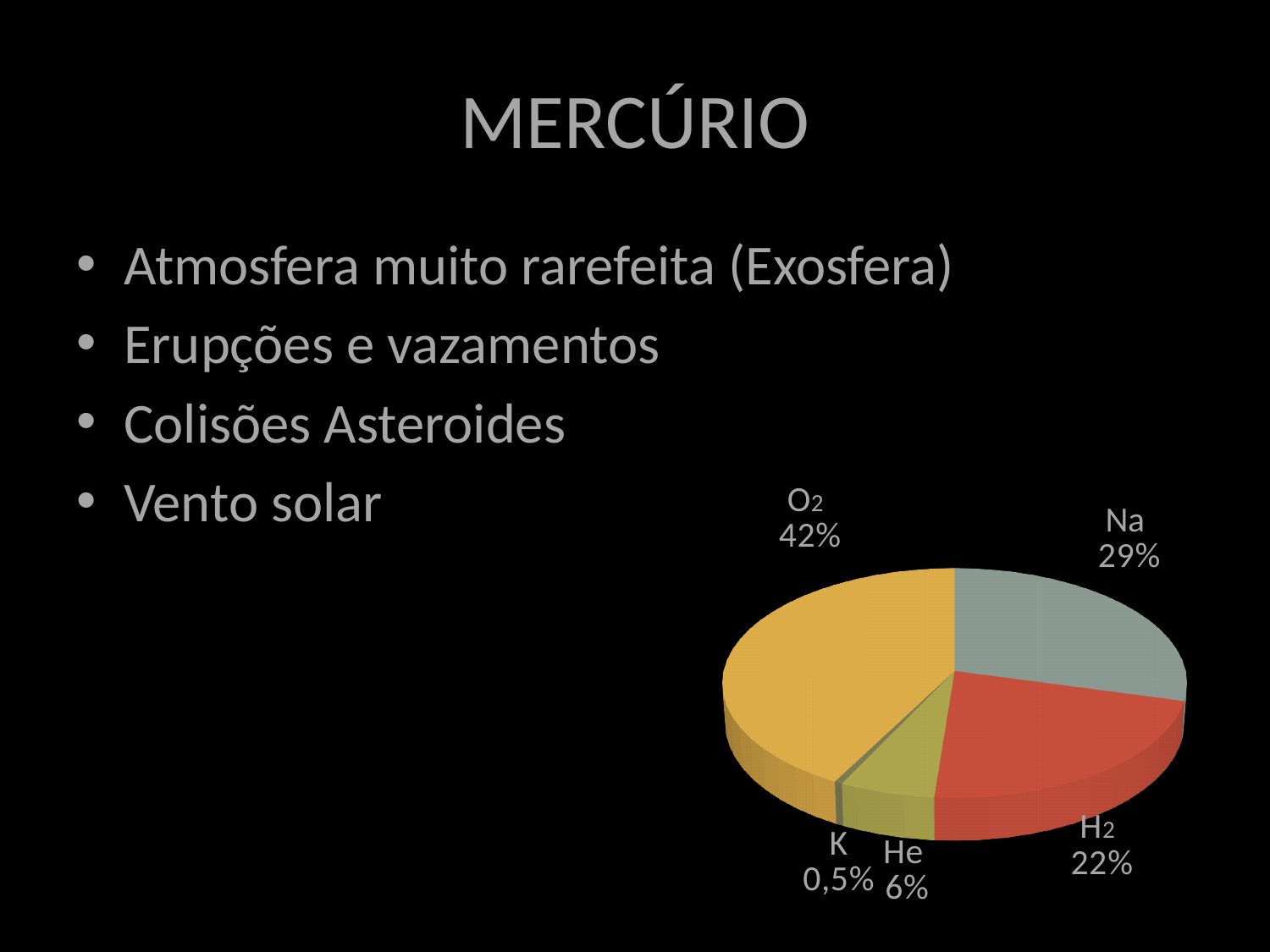
What is the difference in percentage points between the O2 share and the Na share? 13 What share of the pie does H2 have? 22% What kind of chart is shown on the slide? pie chart What share of the pie does He have? 6% What share of the pie does Na have? 29% What share of the pie does O2 have? 42% How many slices does the pie chart have? 5 Which is larger, the share for Na or the share for H2? Na Which slice of the pie is the smallest? K Which slice of the pie is the largest? O2 What colour is the O2 slice of the pie? yellow What share of the pie does K have? 0,5%